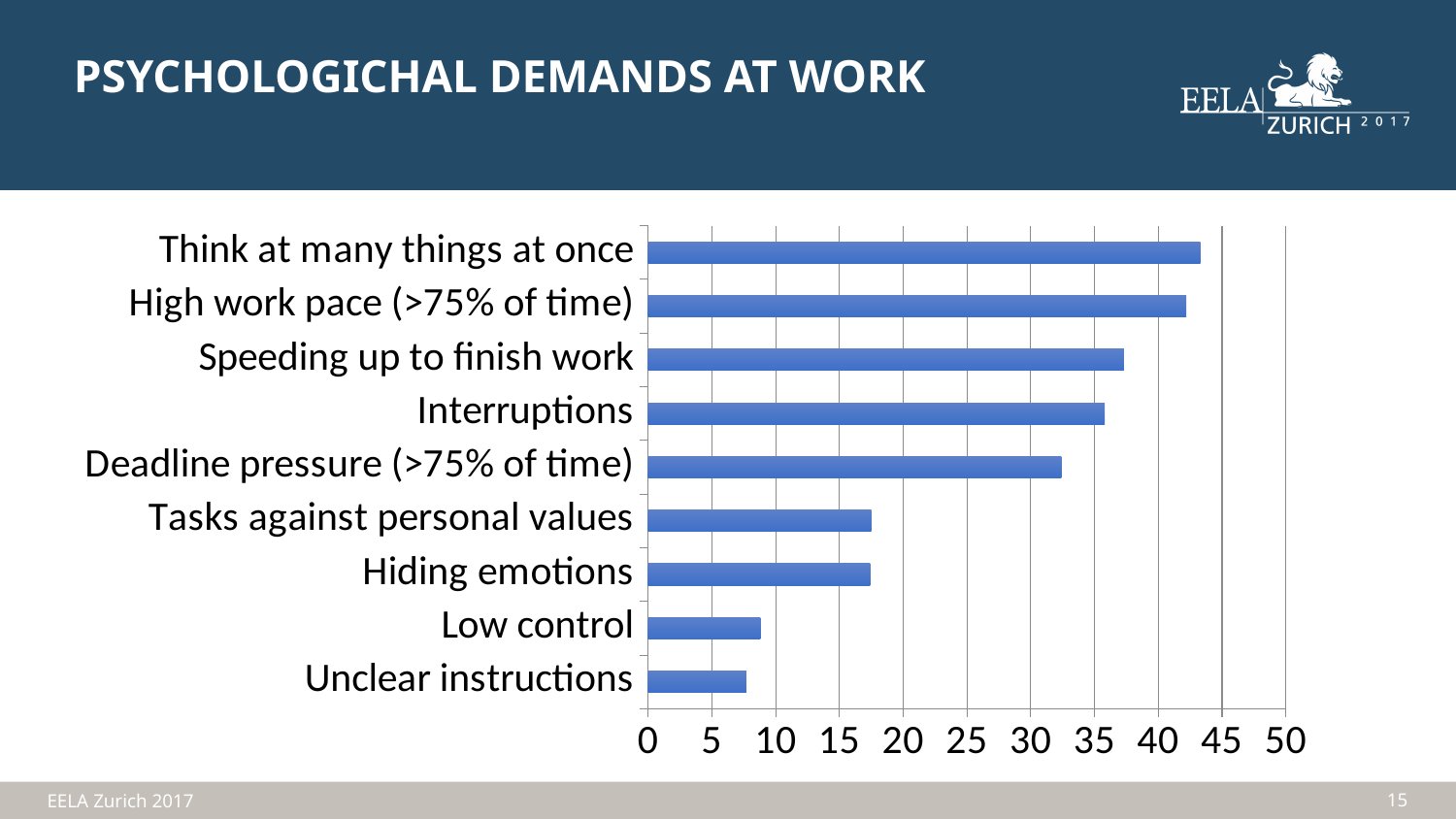
Is the value for Interruptions greater or less than 40? less Is the value for Hiding emotions greater or less than 15? greater Which has the larger value, Low control or Tasks against personal values? Tasks against personal values Is the value for Think at many things at once greater or less than 40? greater How many categories are plotted in the chart? 9 Which has the larger value, Hiding emotions or Interruptions? Interruptions What is the highest value shown on the horizontal axis of the chart? 50 What kind of chart is shown on the slide? bar chart Which has the larger value, Speeding up to finish work or Deadline pressure (>75% of time)? Speeding up to finish work